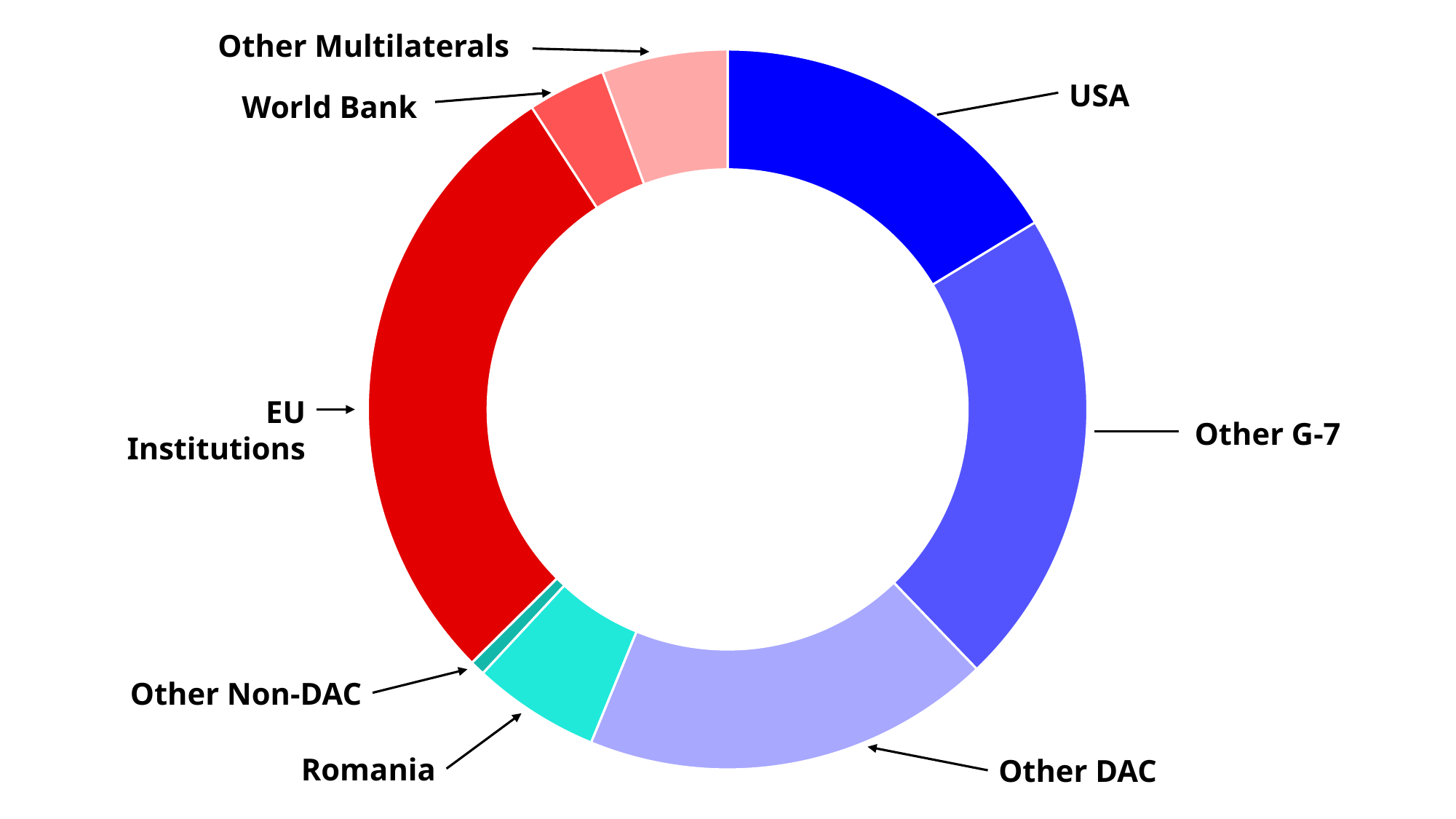
What colour is the USA slice? Dark blue Which slice is larger, Other Multilaterals or Other Non-DAC? Other Multilaterals Which slice is larger, USA or Other G-7? Other G-7 Which slice is larger, EU Institutions or Other DAC? EU Institutions Which category has the smallest slice in the donut chart? Other Non-DAC What colour is the EU Institutions slice? Red How many categories are shown in the donut chart? 8 What kind of chart is shown on the slide? Pie chart (donut) Which category has the largest slice in the donut chart? EU Institutions